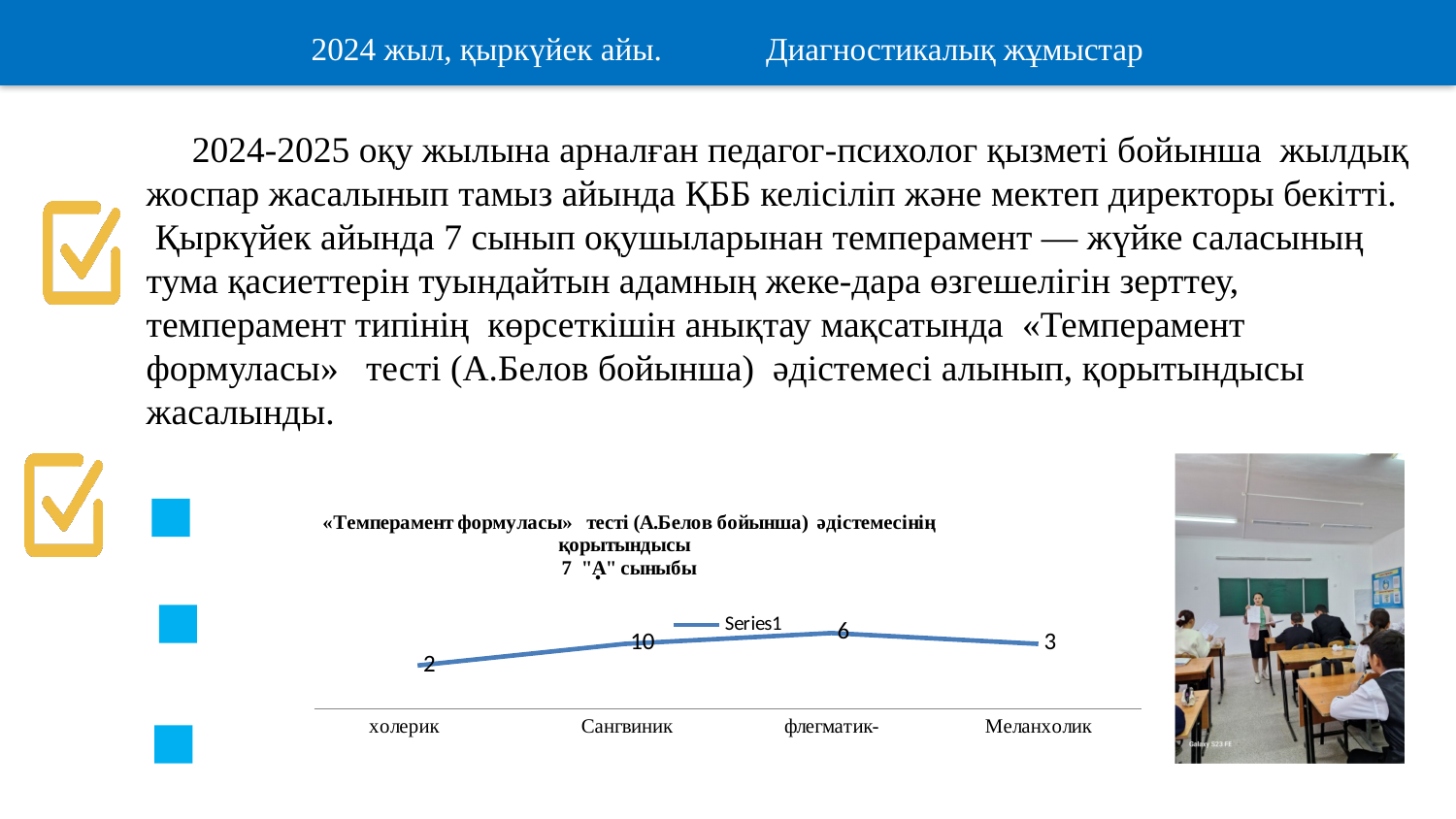
Which is larger, the value for флегматик- or the value for Меланхолик? флегматик- How many series does the legend list? 1 How many categories are plotted on the x axis? 4 Which category has the lowest value? холерик What is the value for Меланхолик? 3 What is the difference between the values for Сангвиник and флегматик-? 4 What is the value for флегматик-? 6 What type of chart is shown on the slide? line chart What is the name of the series shown in the legend? Series1 What is the value for Сангвиник? 10 What is the value for холерик? 2